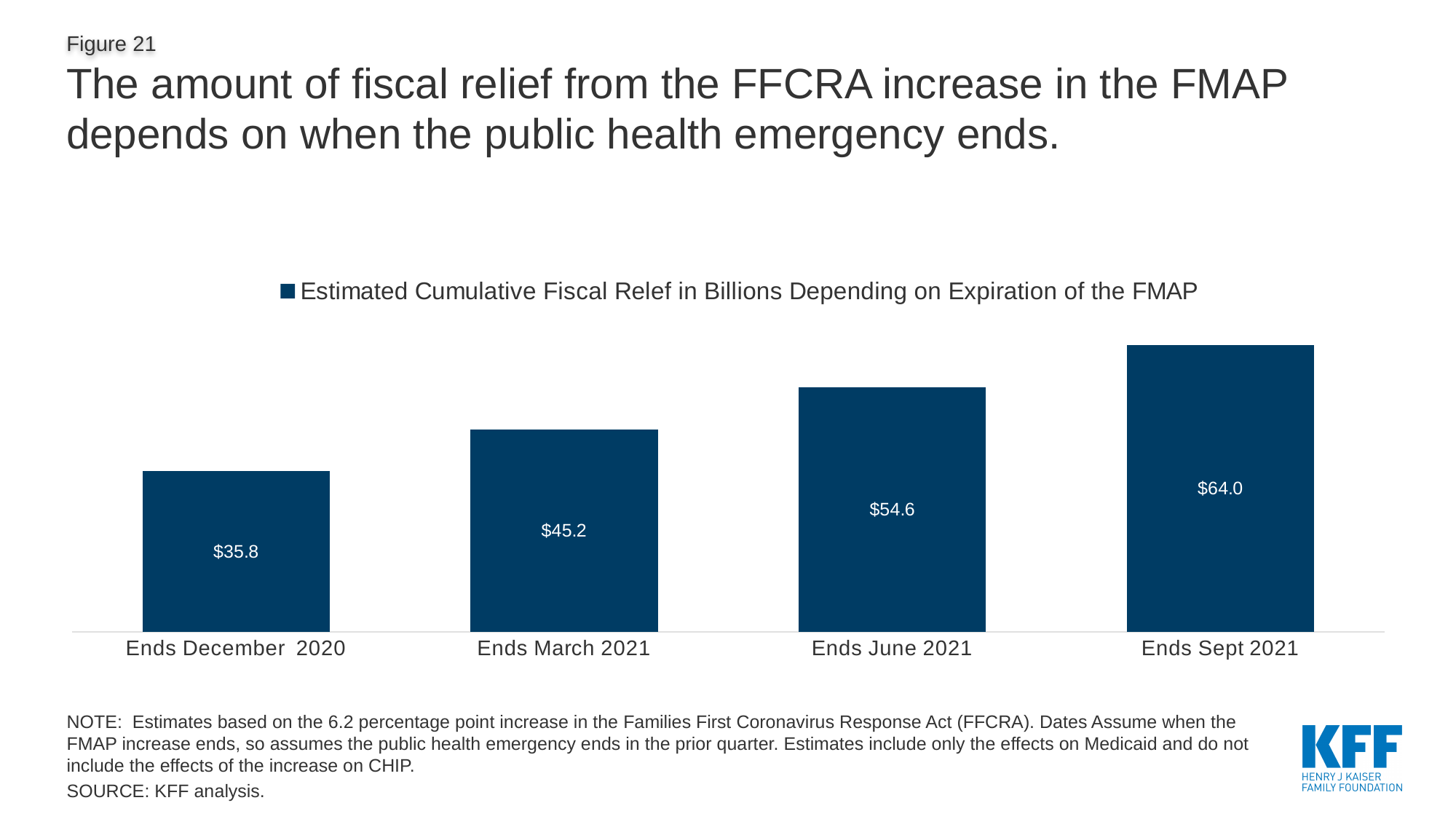
Which is larger, the fiscal relief for Ends March 2021 or Ends June 2021? Ends June 2021 What is the difference in estimated fiscal relief between Ends June 2021 and Ends March 2021? $9.4 Which expiration date has the highest estimated cumulative fiscal relief? Ends Sept 2021 How many expiration-date categories are shown in the chart? 4 Do the values rise or fall as the expiration date moves later along the x axis? Rise What is the estimated cumulative fiscal relief if the FMAP increase ends Sept 2021? $64.0 What is the estimated cumulative fiscal relief if the FMAP increase ends June 2021? $54.6 What is the estimated cumulative fiscal relief if the FMAP increase ends December 2020? $35.8 Which expiration date has the lowest estimated cumulative fiscal relief? Ends December 2020 What is the difference in estimated fiscal relief between Ends Sept 2021 and Ends December 2020? $28.2 What is the estimated cumulative fiscal relief if the FMAP increase ends March 2021? $45.2 What kind of chart is shown on the slide? Bar chart